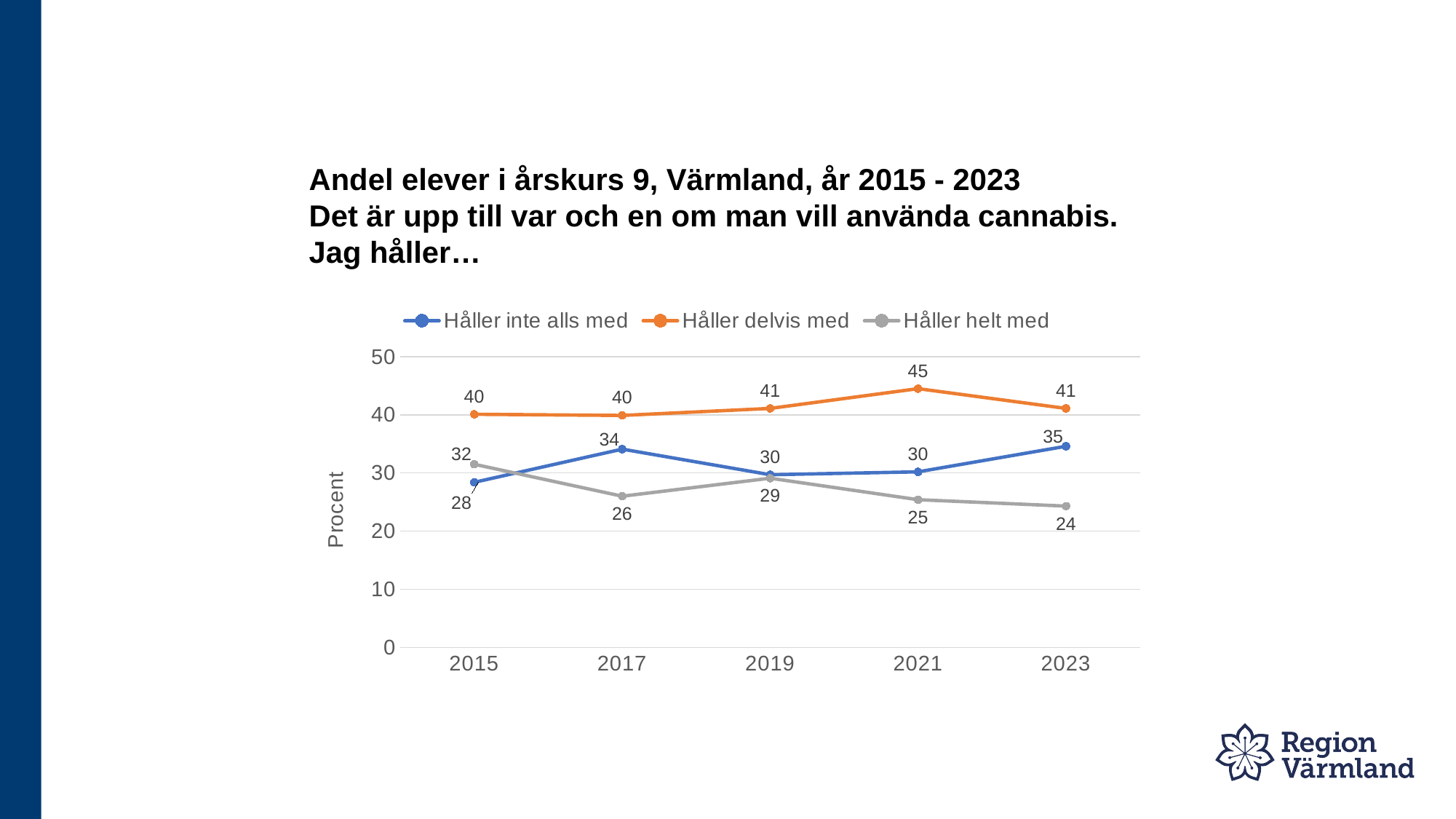
What kind of chart is shown? line chart How many years are shown on the x axis? 5 In which year is "Håller delvis med" highest? 2021 What is the value for "Håller delvis med" in 2021? 45 Which is larger in 2015: "Håller inte alls med" or "Håller helt med"? Håller helt med How many series does the legend list? 3 In which year is "Håller helt med" lowest? 2023 What is the value for "Håller inte alls med" in 2015? 28 Does "Håller helt med" rise or fall from 2015 to 2023? fall What is the value for "Håller helt med" in 2023? 24 Is the value for "Håller inte alls med" in 2023 greater or less than 30? greater What is the difference between "Håller delvis med" and "Håller helt med" in 2023? 17